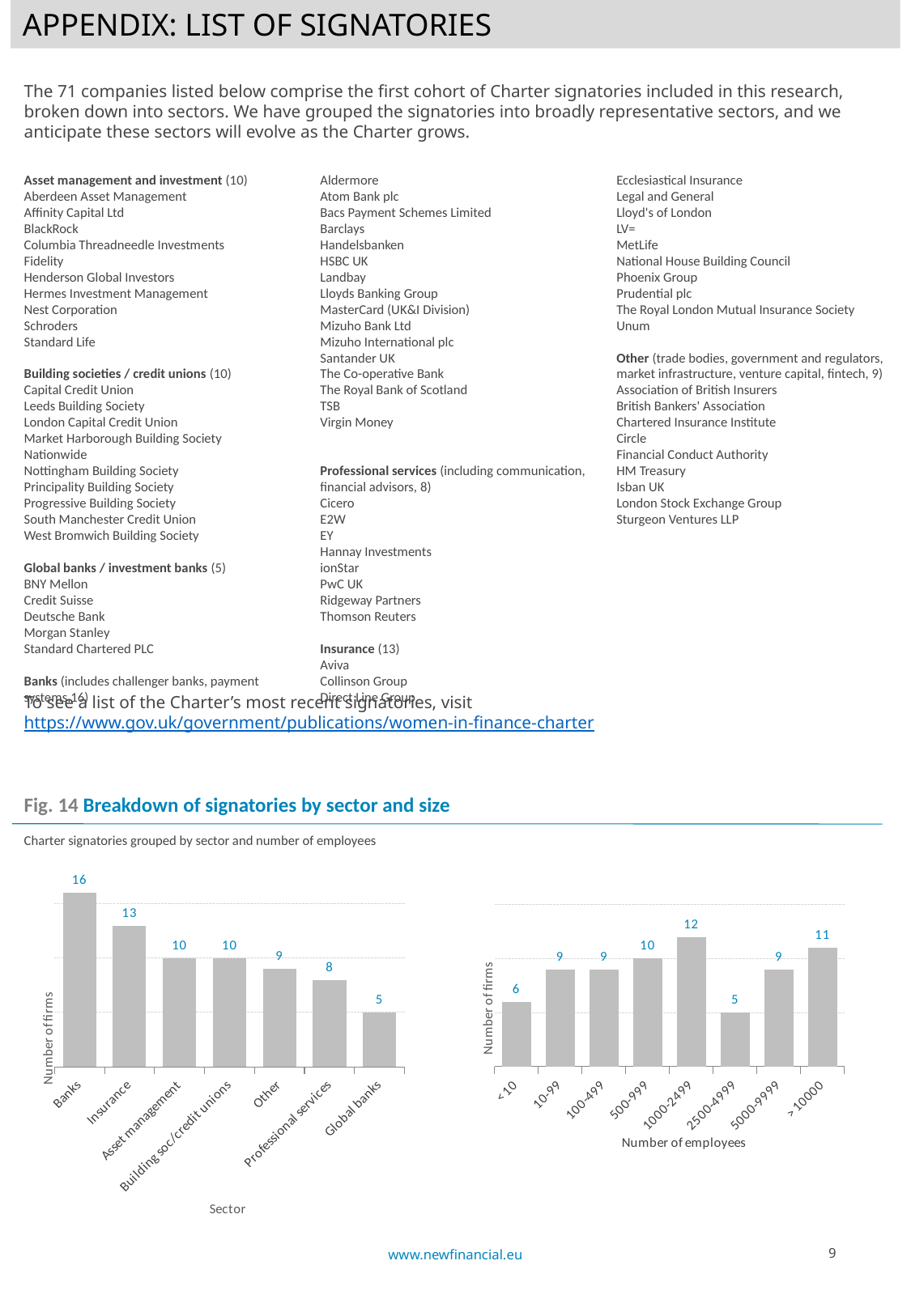
In the left chart (signatories by sector), how many sectors are shown on the x axis? 7 What is the title of Fig. 14? Breakdown of signatories by sector and size What type of chart is used in Fig. 14 to show the breakdown of signatories? Bar chart In the right chart (signatories by number of employees), which employee-size band has the fewest firms? 2500-4999 In the left chart (signatories by sector), what is the difference between the number of firms in Banks and in Insurance? 3 In the right chart (signatories by number of employees), how many firms have 1000-2499 employees? 12 In the right chart (signatories by number of employees), what is the difference between the number of firms with >10000 employees and those with <10 employees? 5 In the right chart (signatories by number of employees), which employee-size band has the most firms? 1000-2499 In the left chart (signatories by sector), how many firms are in the Banks sector? 16 In the left chart (signatories by sector), which sector has the fewest firms? Global banks In the right chart (signatories by number of employees), how many employee-size bands are shown? 8 In the left chart (signatories by sector), which has more firms, Other or Professional services? Other